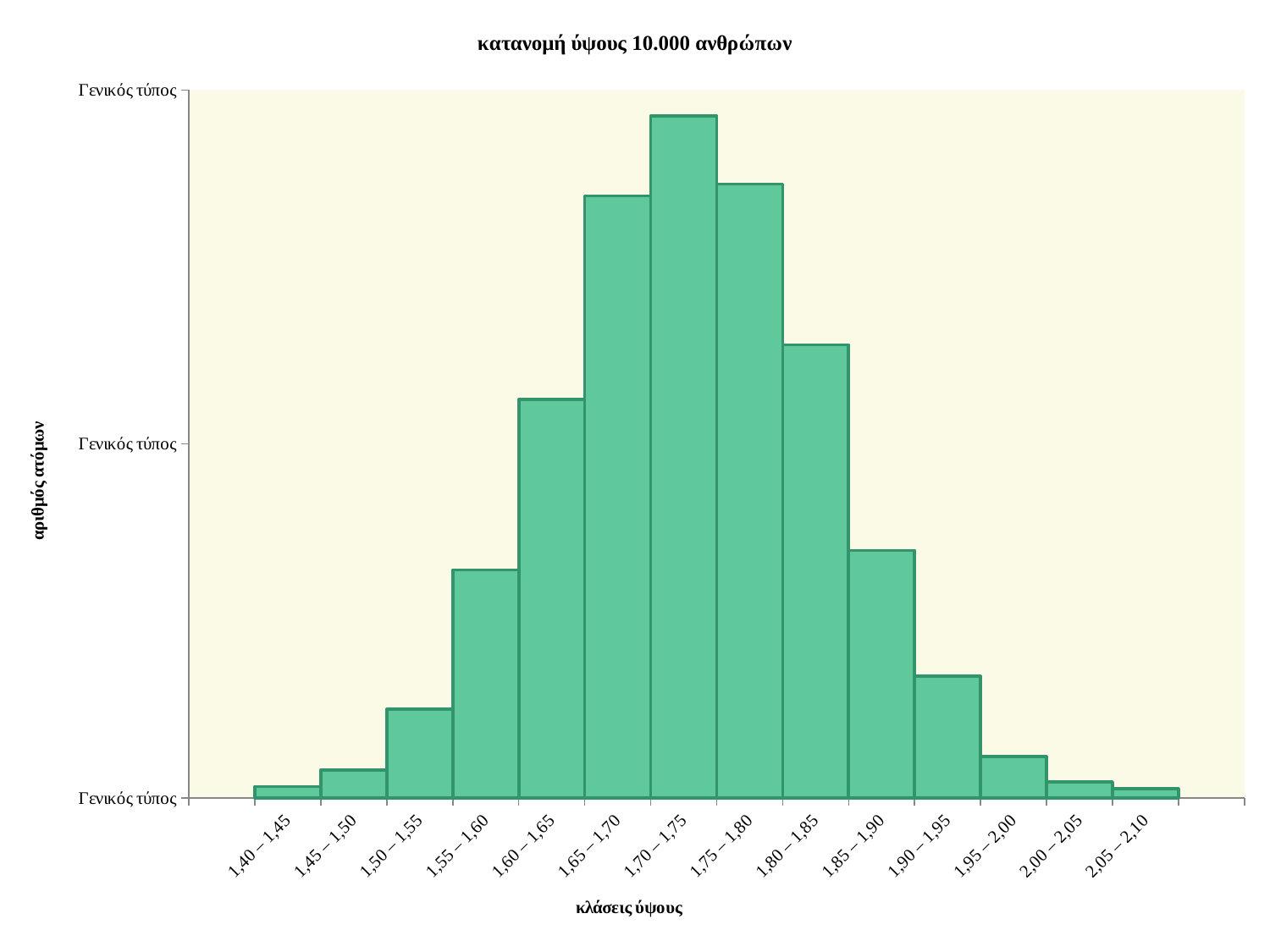
Do the bar heights rise or fall from 1,40 – 1,45 to 1,70 – 1,75? rise Which bar is taller: 1,55 – 1,60 or 1,85 – 1,90? 1,85 – 1,90 What is the title of the chart? κατανομή ύψους 10.000 ανθρώπων Which bar is taller: 1,65 – 1,70 or 1,70 – 1,75? 1,70 – 1,75 Do the bar heights rise or fall from 1,70 – 1,75 to 2,05 – 2,10? fall Which height class has the highest bar? 1,70 – 1,75 Which bar is taller: 1,60 – 1,65 or 1,80 – 1,85? 1,80 – 1,85 What is the label of the x axis? κλάσεις ύψους How many height classes (bars) are shown on the x axis? 14 What kind of chart is shown on the slide? bar chart